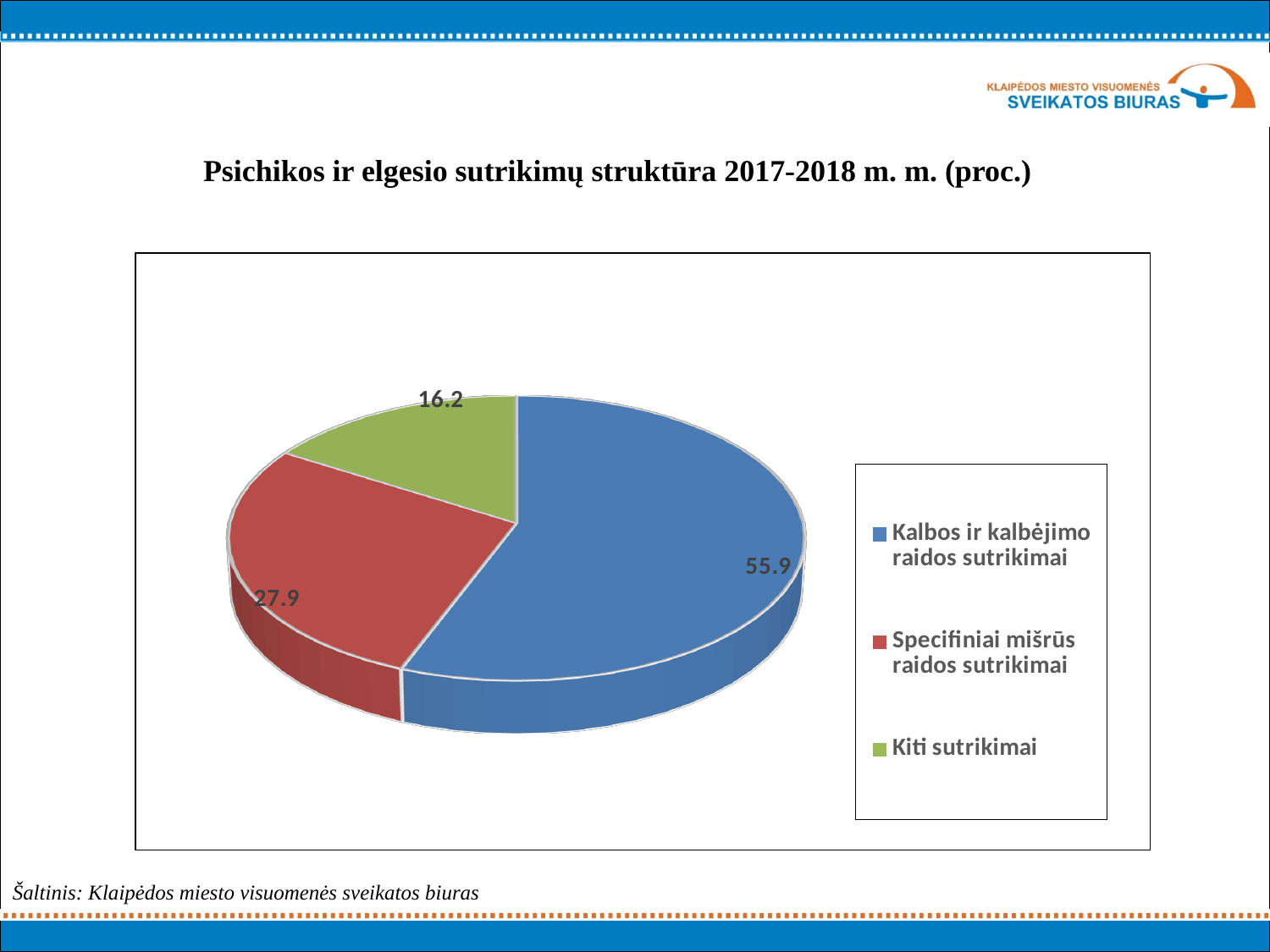
Which is larger: the value for Specifiniai mišrūs raidos sutrikimai or the value for Kiti sutrikimai? Specifiniai mišrūs raidos sutrikimai What is the value for Kiti sutrikimai? 16.2 What is the value for Kalbos ir kalbėjimo raidos sutrikimai? 55.9 What is the value for Specifiniai mišrūs raidos sutrikimai? 27.9 What type of chart is shown on the slide? Pie chart Which category has the largest share of the pie? Kalbos ir kalbėjimo raidos sutrikimai What colour is the slice for Kiti sutrikimai? Green Which category has the smallest share of the pie? Kiti sutrikimai What is the title of the chart? Psichikos ir elgesio sutrikimų struktūra 2017-2018 m. m. (proc.) How many slices does the pie chart have? 3 What is the difference between the values for Kalbos ir kalbėjimo raidos sutrikimai and Specifiniai mišrūs raidos sutrikimai? 28.0 What is the difference between the values for Specifiniai mišrūs raidos sutrikimai and Kiti sutrikimai? 11.7